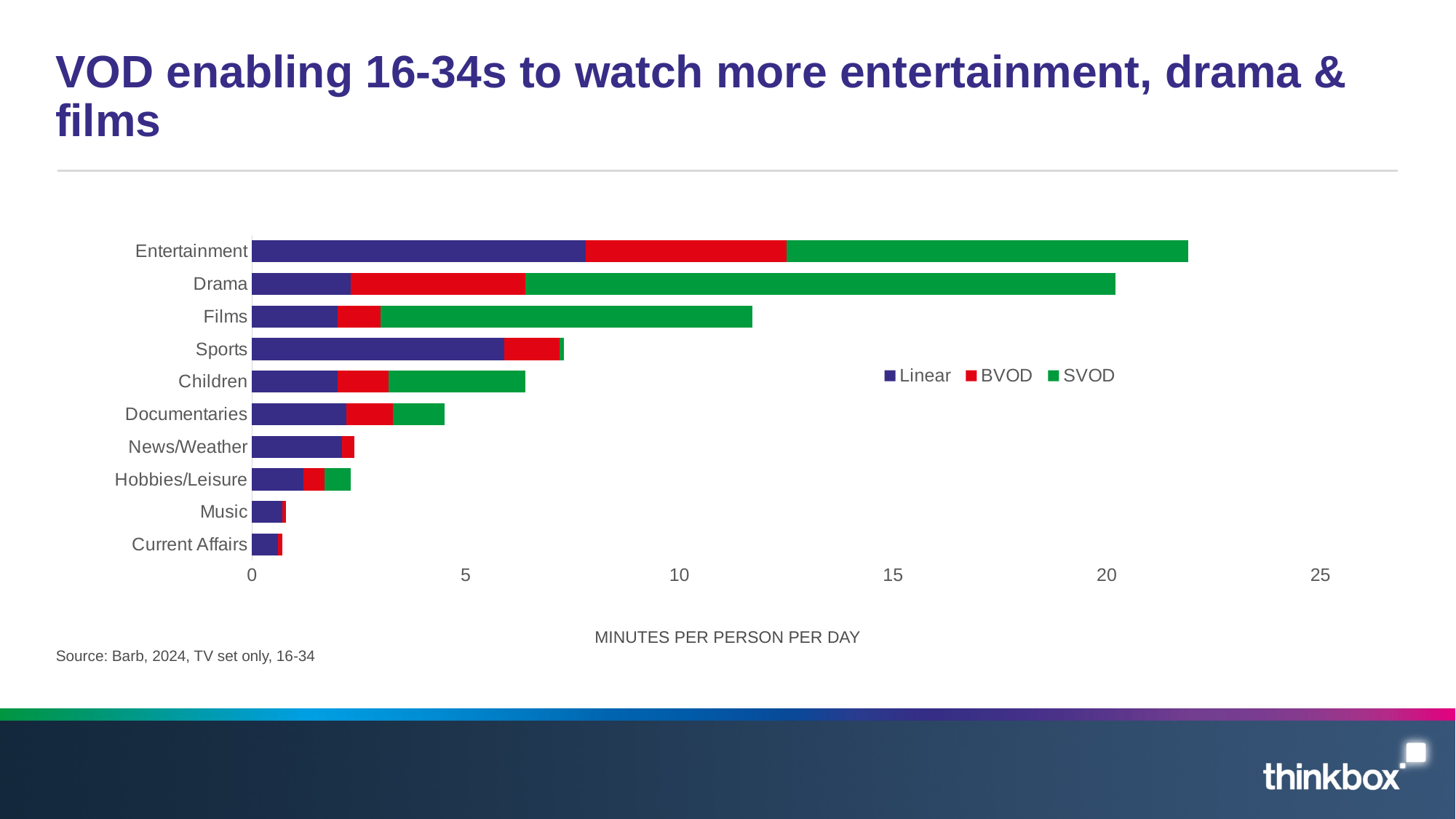
Which has a larger total, Children or Documentaries? Children Is the total value for Sports greater or less than 5? greater How many categories are plotted on the chart? 10 Is the total value for Entertainment greater or less than 20? greater What kind of chart is shown on the slide? Stacked bar chart What is the label on the horizontal axis of the chart? MINUTES PER PERSON PER DAY Which has a larger total, Films or Sports? Films Is the total value for Films greater or less than 10? greater Which category has the highest total minutes per person per day? Entertainment How many series does the legend list? 3 What are the three series named in the legend? Linear, BVOD, SVOD